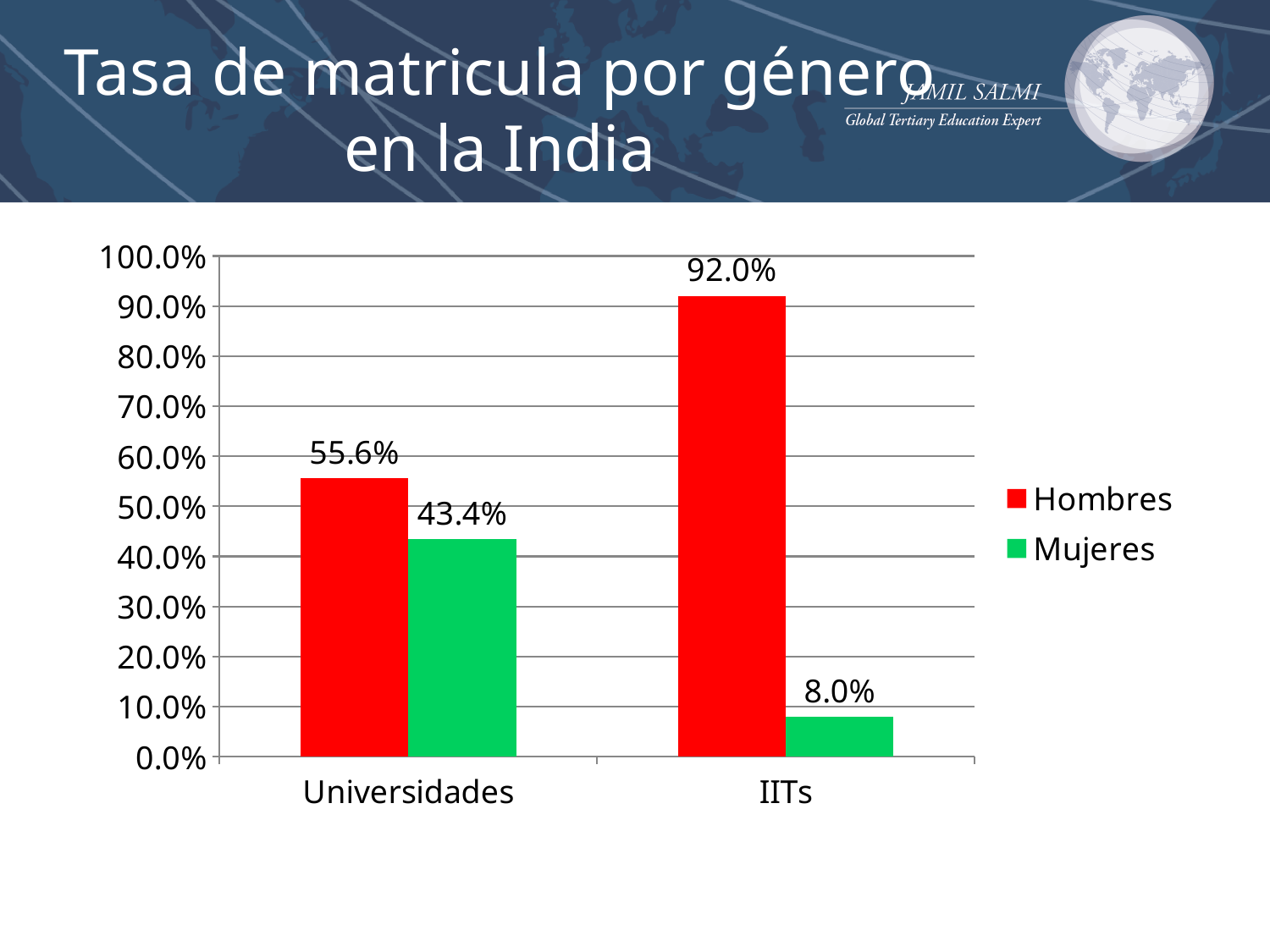
How many categories are shown on the x axis? 2 What is the difference between the Hombres and Mujeres values for IITs? 84.0% What is the value for Hombres in the Universidades category? 55.6% What is the difference between the Hombres values for IITs and Universidades? 36.4% How many series does the legend list? 2 What kind of chart is shown on the slide? Bar chart What is the value for Mujeres in the IITs category? 8.0% Which category has the highest Hombres value? IITs What is the value for Hombres in the IITs category? 92.0% What is the value for Mujeres in the Universidades category? 43.4% Which is larger, the Mujeres value for Universidades or the Mujeres value for IITs? Universidades Which category has the lowest Mujeres value? IITs